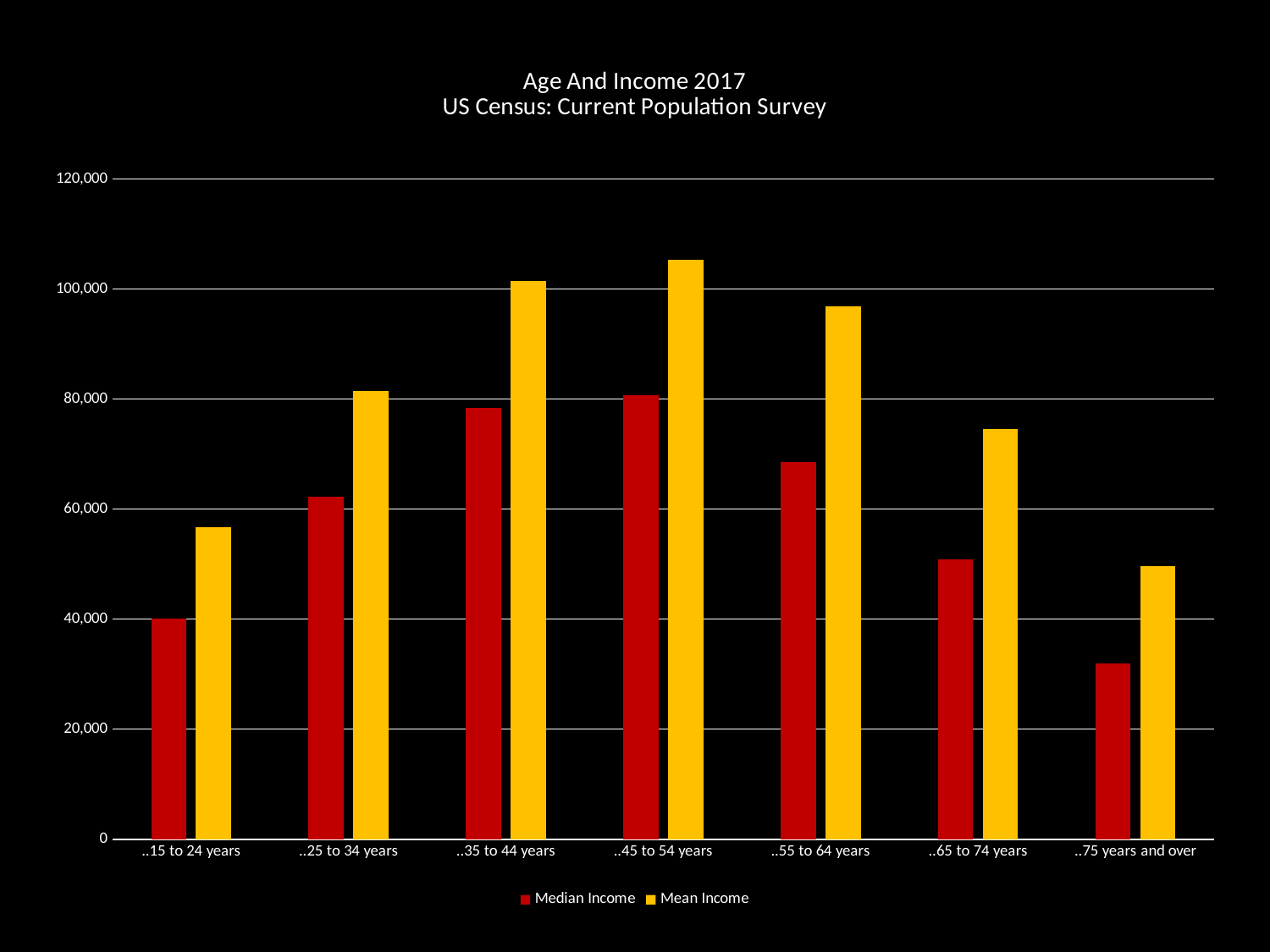
Which age group has the lowest Median Income? ..75 years and over What kind of chart is shown on the slide? Bar chart Which age group has the highest Mean Income? ..45 to 54 years How many series does the legend list? 2 How many age categories are shown on the x axis? 7 Is the Mean Income for ..65 to 74 years greater or less than 80,000? less Is the Median Income for ..75 years and over greater or less than 40,000? less Which age group has the lowest Mean Income? ..75 years and over What colour are the Mean Income bars? Yellow Do the Median Income values rise or fall from ..45 to 54 years to ..75 years and over? Fall Is the Mean Income for ..35 to 44 years greater or less than 100,000? greater Which is larger: the Mean Income for ..55 to 64 years or the Mean Income for ..35 to 44 years? Mean Income for ..35 to 44 years